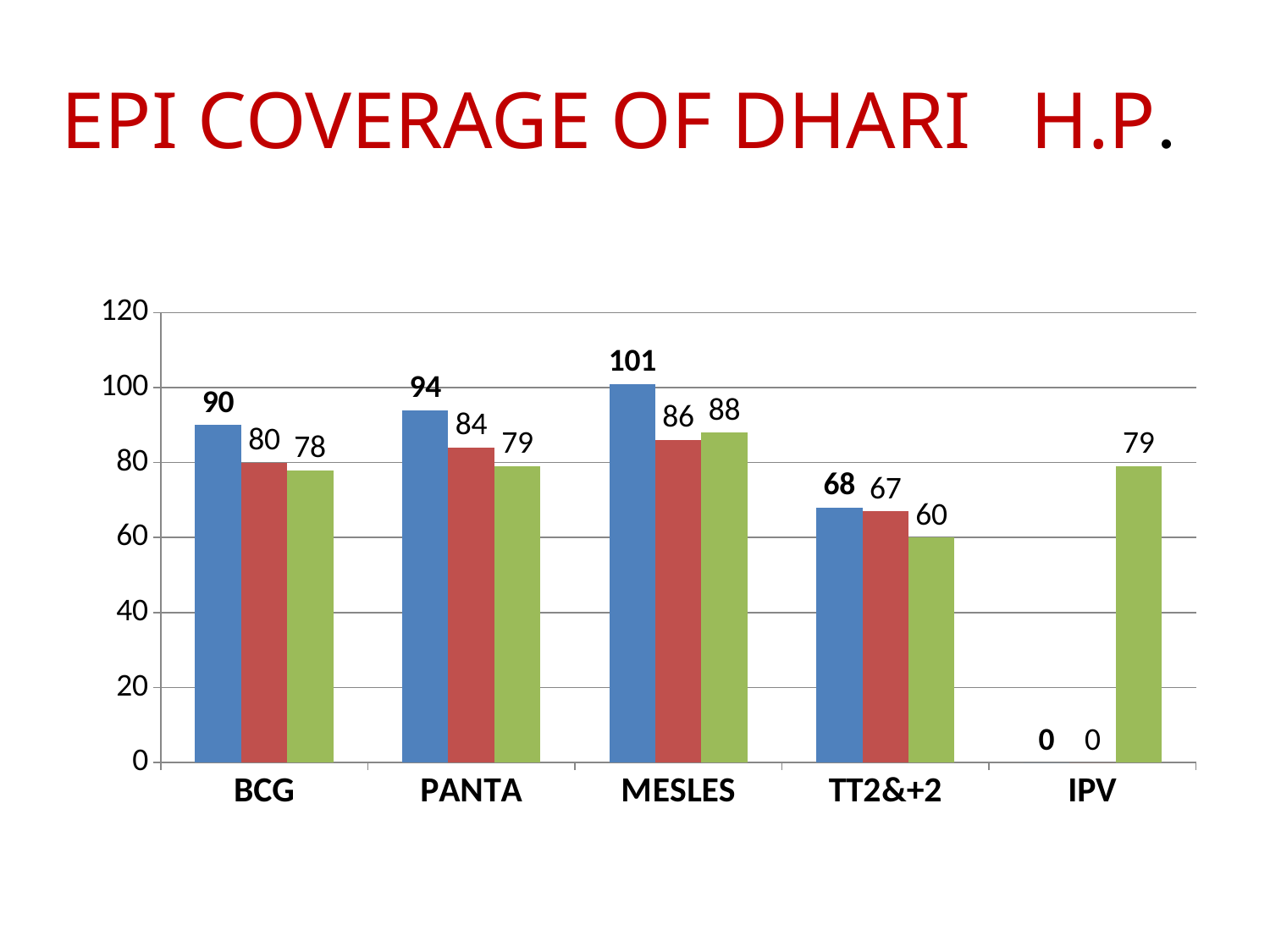
What is the value of the green bar for IPV? 79 Which category has the lowest green bar? TT2&+2 What kind of chart is shown on the slide? bar chart Which is larger, the red bar for PANTA or the red bar for BCG? PANTA What is the value of the blue bar for IPV? 0 What is the value of the red bar for MESLES? 86 What is the title of the slide? EPI COVERAGE OF DHARI H.P. Which category has the highest blue bar? MESLES How many categories are shown on the x axis? 5 What is the value of the blue bar for BCG? 90 Is the blue bar for MESLES greater or less than 100? greater What is the difference between the blue bar for MESLES and the blue bar for TT2&+2? 33